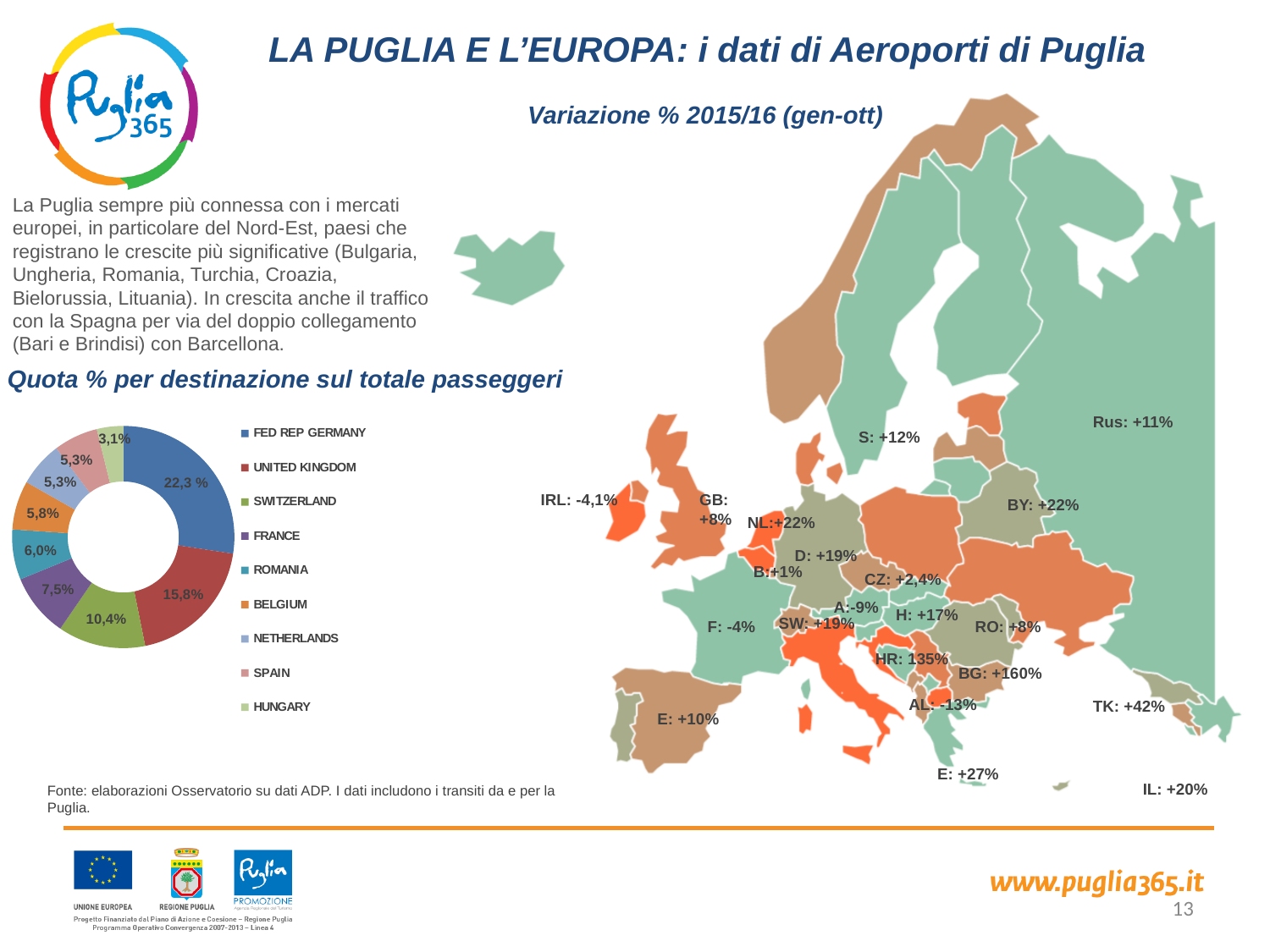
What kind of chart is used to show the 'Quota % per destinazione sul totale passeggeri'? doughnut (pie) chart In the doughnut chart, what share of total passengers does FED REP GERMANY have? 22,3 % Which destination has the largest share in the doughnut chart? FED REP GERMANY In the doughnut chart, what is the share for SWITZERLAND? 10,4% In the doughnut chart, what is the share for UNITED KINGDOM? 15,8% In the doughnut chart, which has the larger share: FRANCE or ROMANIA? FRANCE What is the title of the doughnut chart on the slide? Quota % per destinazione sul totale passeggeri How many destinations are listed in the legend of the doughnut chart? 9 In the doughnut chart, what is the share for HUNGARY? 3,1% Which destination has the smallest share in the doughnut chart? HUNGARY In the doughnut chart, how much larger is the share of FED REP GERMANY than that of UNITED KINGDOM? 6,5% In the doughnut chart, what is the share for FRANCE? 7,5%